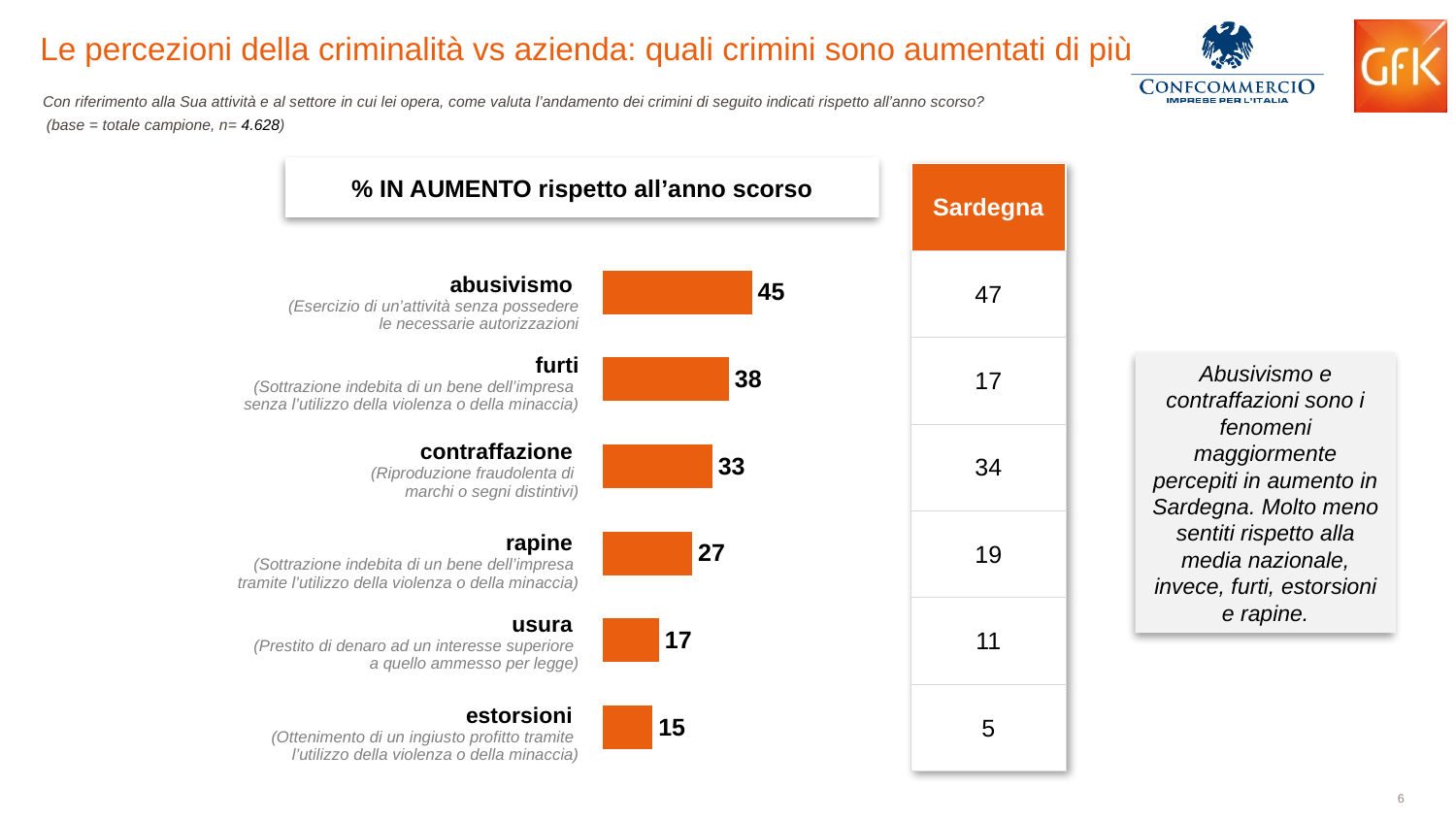
What is the value for rapine in the bar chart? 27 What is the title shown above the bar chart? % IN AUMENTO rispetto all'anno scorso What is the value for estorsioni in the bar chart? 15 What is the difference between the bar chart value for furti and the Sardegna value for furti? 21 Which category has the lowest value in the bar chart? estorsioni What is the value for abusivismo in the bar chart? 45 Which category has the highest value in the bar chart? abusivismo Which is larger in the bar chart, the value for usura or the value for rapine? rapine How many categories are shown in the bar chart? 6 What is the Sardegna value for contraffazione in the table next to the chart? 34 What kind of chart is shown on the slide? bar chart What is the difference between the values for furti and contraffazione in the bar chart? 5